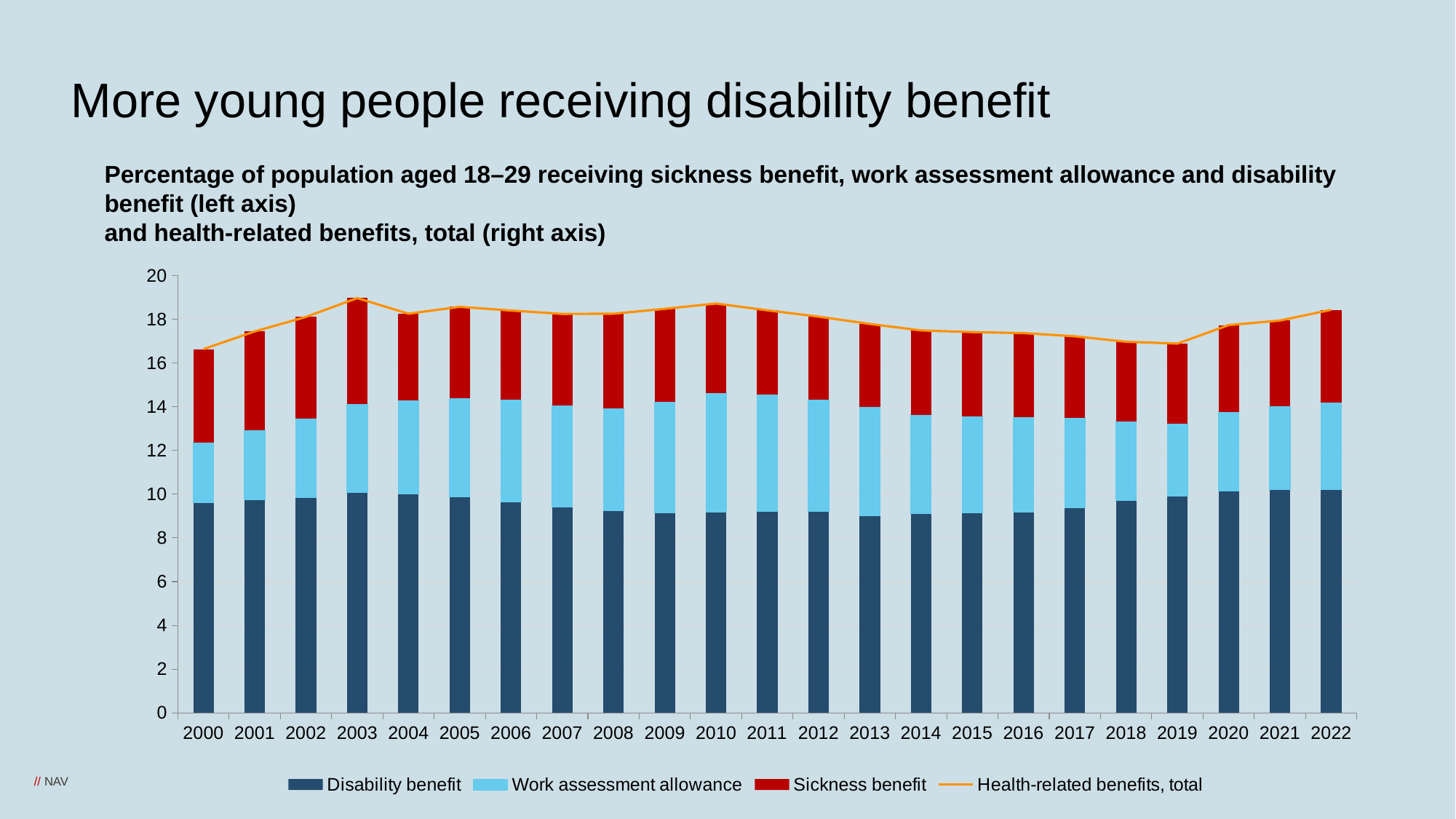
What kind of chart is shown on the slide? Stacked bar chart with a line Is the total height of the stacked bar for 2019 greater or less than 18? less Is the total height of the stacked bar for 2003 greater or less than 18? greater Which series is drawn as a line rather than as bars? Health-related benefits, total Is the value for Disability benefit in 2000 greater or less than 10? less How many years are shown along the x axis of the chart? 23 What colour are the Sickness benefit segments in the bars? Red Which year has the tallest stacked bar? 2003 Which stacked bar is taller, 2003 or 2019? 2003 Does the Disability benefit series rise or fall from 2013 to 2022? Rises How many series does the chart's legend list? 4